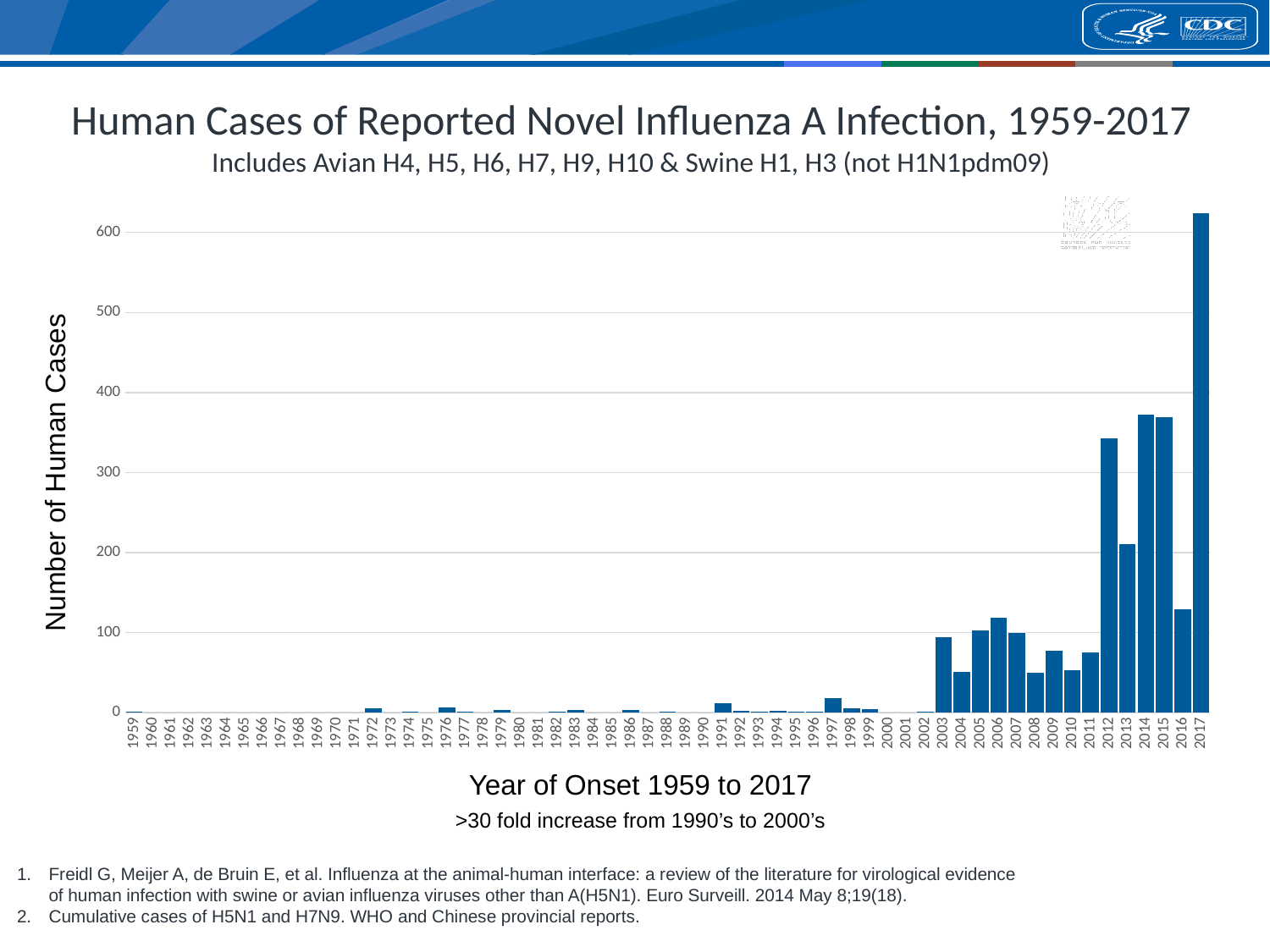
Which year has more human cases, 2017 or 2015? 2017 Is the value for 2013 greater or less than 300? less How many years are shown on the x axis? 59 Which year has the highest number of human cases? 2017 Is the value for 2004 greater or less than 100? less Is the value for 2014 greater or less than 400? less What kind of chart is shown on the slide? bar chart Which year has more human cases, 2012 or 2013? 2012 What is the label of the y axis? Number of Human Cases